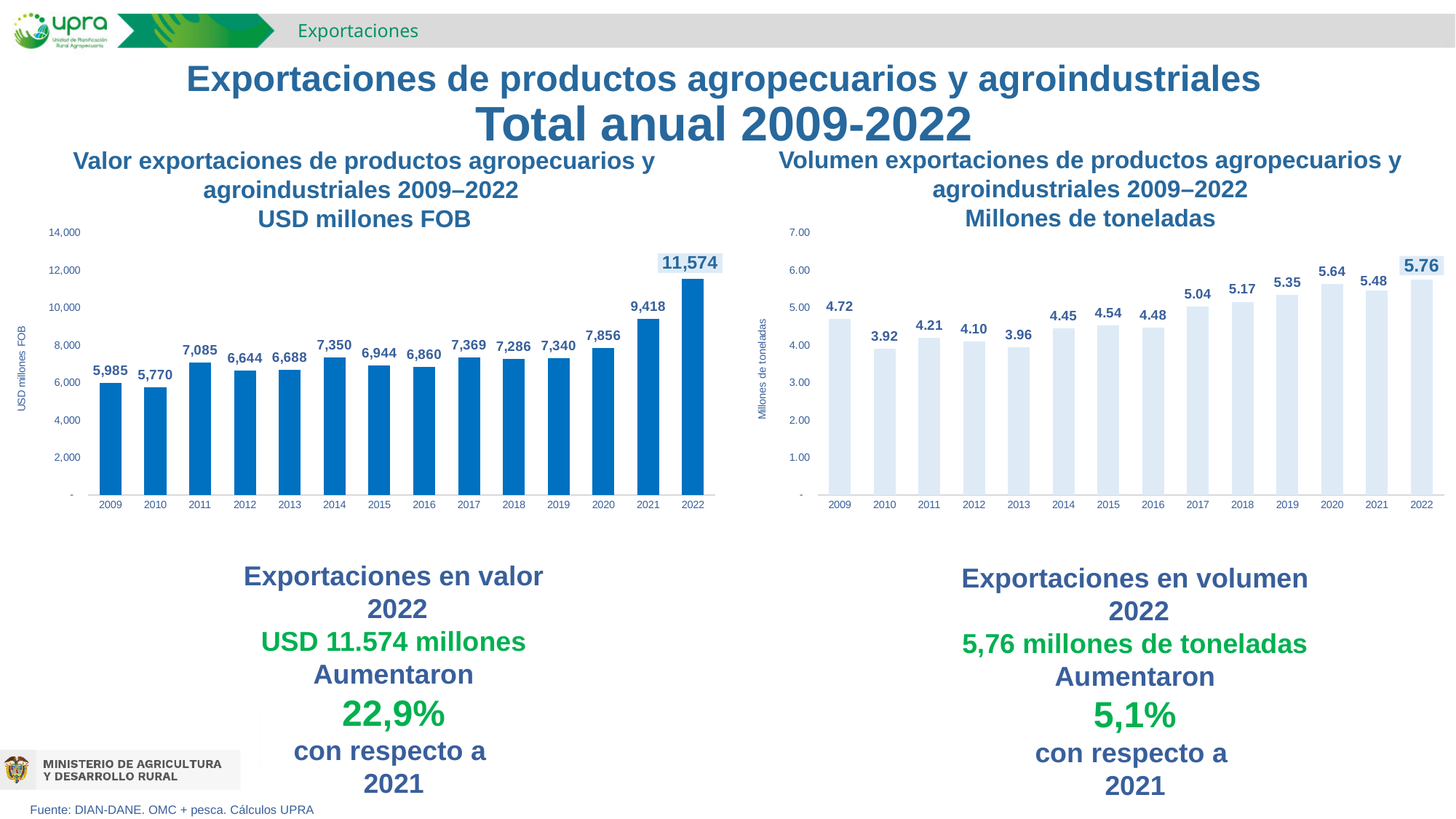
In the right chart (Volumen exportaciones, Millones de toneladas), which year has the lowest value? 2010 What type of chart is the right chart (Volumen exportaciones, Millones de toneladas)? Bar chart In the right chart (Volumen exportaciones, Millones de toneladas), which year has the highest value? 2022 In the left chart (Valor exportaciones, USD millones FOB), how many years are shown on the x axis? 14 In the right chart (Volumen exportaciones, Millones de toneladas), what is the difference between the 2022 and 2021 values? 0.28 In the left chart (Valor exportaciones, USD millones FOB), is the value for 2021 greater or less than 8,000? greater In the left chart (Valor exportaciones, USD millones FOB), what is the difference between the 2022 and 2021 values? 2,156 In the left chart (Valor exportaciones, USD millones FOB), which year has the lowest value? 2010 In the right chart (Volumen exportaciones, Millones de toneladas), what is the value for 2009? 4.72 In the right chart (Volumen exportaciones, Millones de toneladas), which is larger, the value for 2020 or the value for 2021? 2020 In the left chart (Valor exportaciones, USD millones FOB), what is the value for 2022? 11,574 In the left chart (Valor exportaciones, USD millones FOB), what is the value for 2010? 5,770